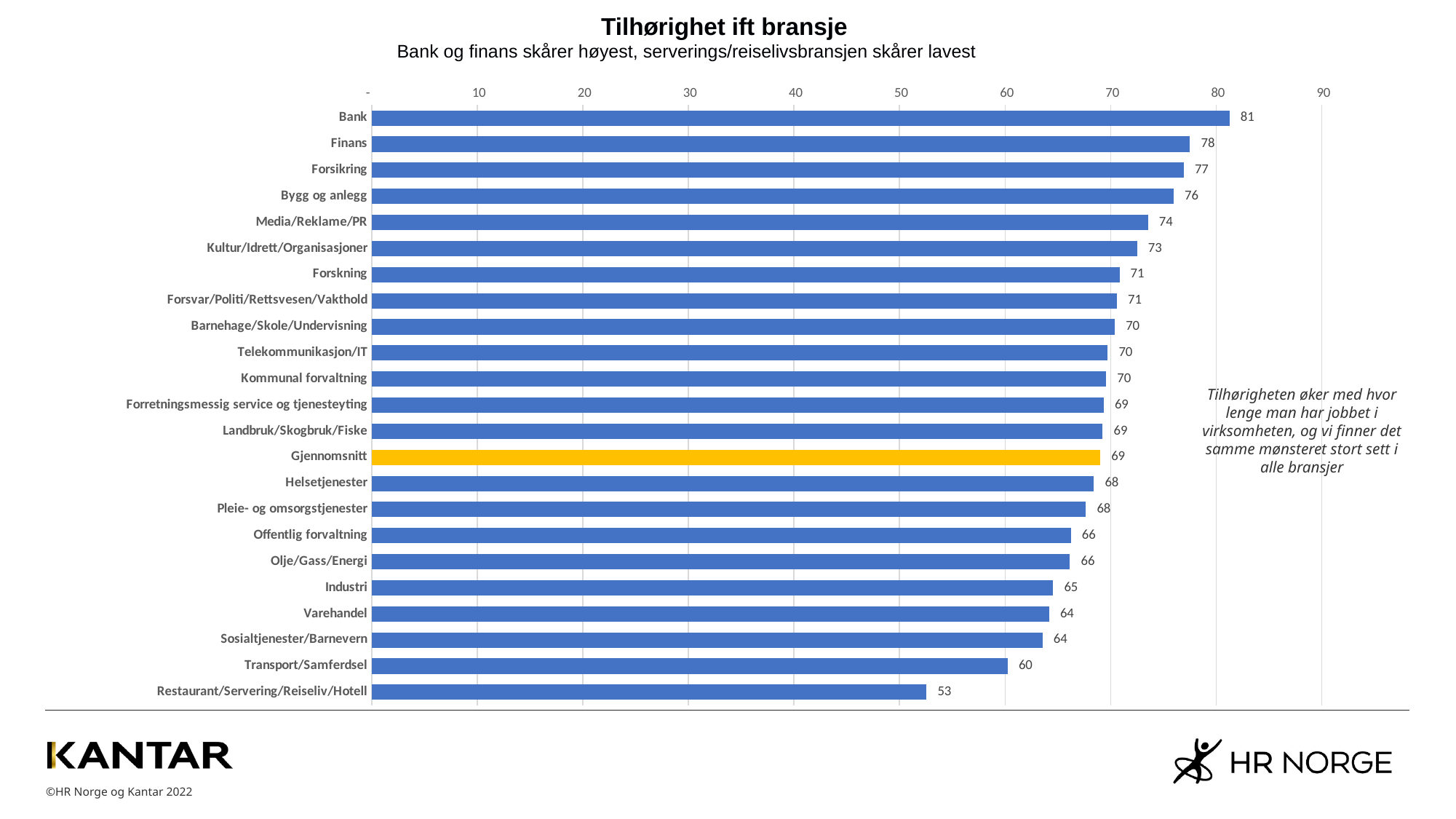
What is the value for Bank? 81 Which category has the highest value? Bank Which has a larger value, Bygg og anlegg or Varehandel? Bygg og anlegg Which category has the lowest value? Restaurant/Servering/Reiseliv/Hotell What is the difference between the values for Finans and Industri? 13 What is the value for Restaurant/Servering/Reiseliv/Hotell? 53 Which bar is shown in a different colour (yellow) from the others? Gjennomsnitt What is the value for Transport/Samferdsel? 60 What kind of chart is shown on the slide? Bar chart How many bars are shown in the chart, including Gjennomsnitt? 23 What is the value for Gjennomsnitt? 69 What is the difference between the values for Bank and Restaurant/Servering/Reiseliv/Hotell? 28